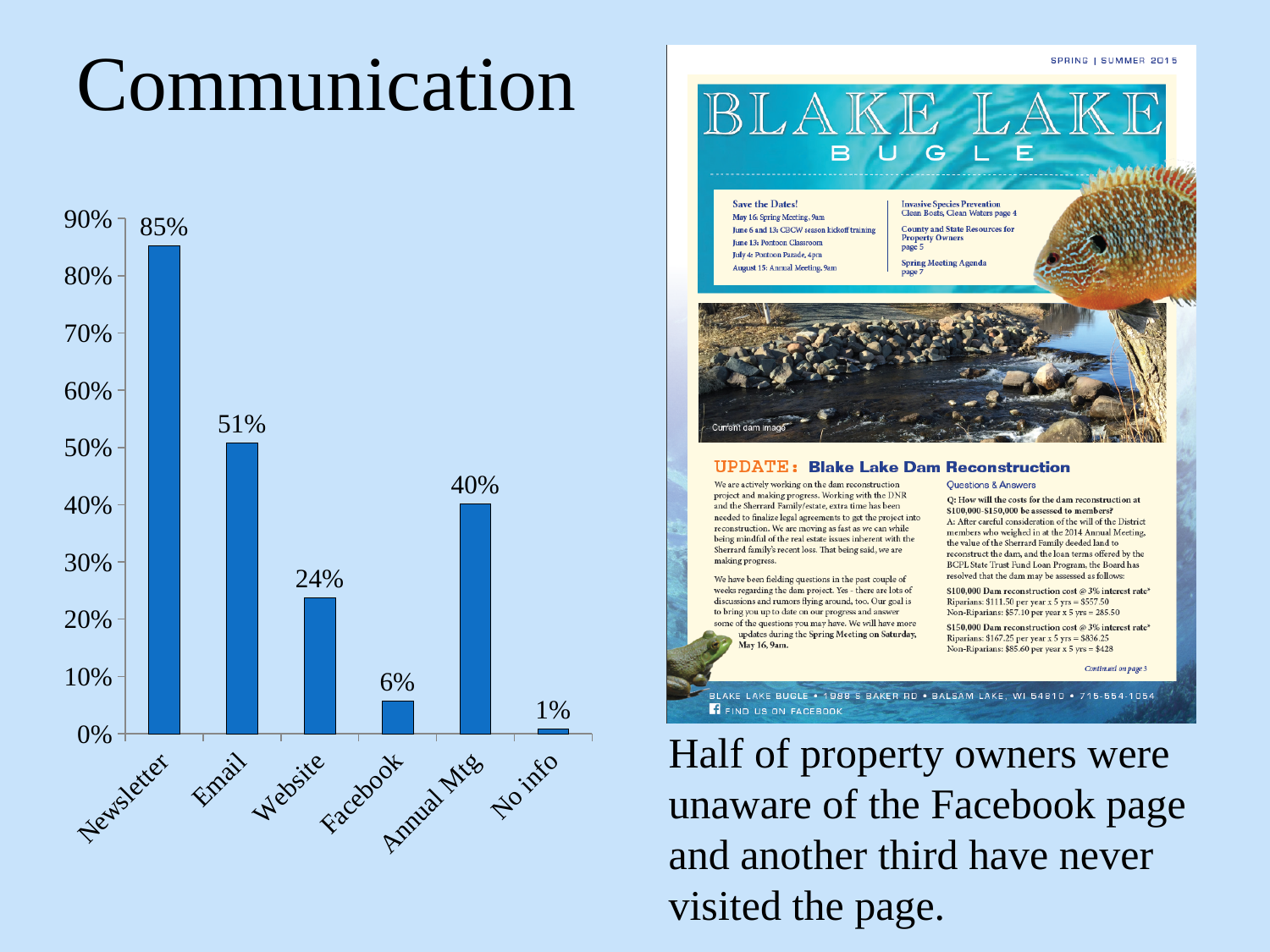
Which category has the lowest value? No info What kind of chart is shown on the slide? bar chart Which is larger, the value for Website or the value for Annual Mtg? Annual Mtg Is the value for Email greater or less than 50%? greater What is the difference between the values for Newsletter and Email? 34% What is the value for Annual Mtg? 40% What is the difference between the values for Annual Mtg and Website? 16% What is the value for Facebook? 6% What is the value for Email? 51% What is the value for Newsletter? 85% How many categories are shown on the x axis? 6 Which category has the highest value? Newsletter